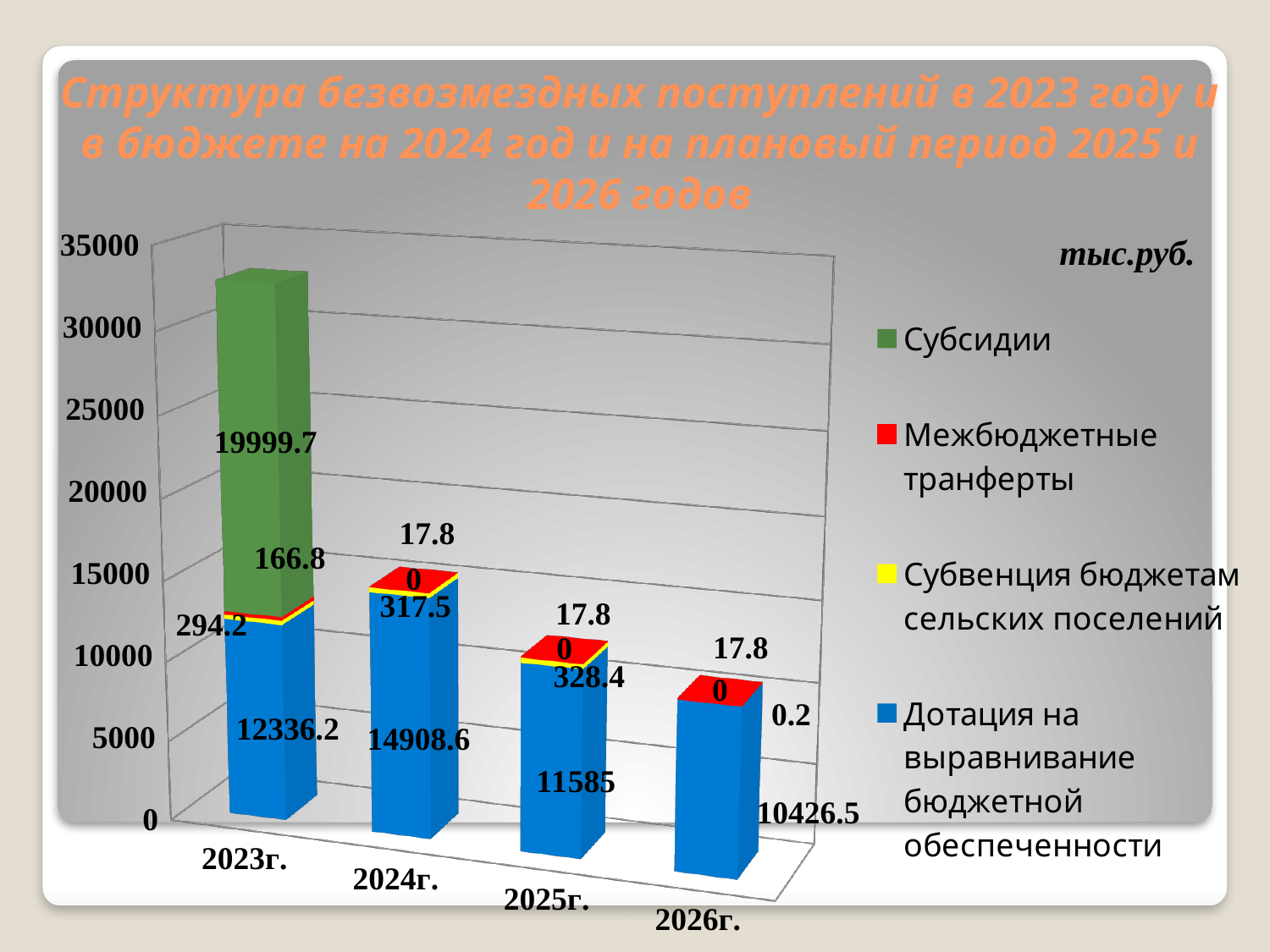
What is the value of Дотация на выравнивание бюджетной обеспеченности for 2023г.? 12336.2 In which year is Дотация на выравнивание бюджетной обеспеченности the highest? 2024г. How many years (categories) are shown on the x axis? 4 What is the total of the stacked bar for 2023г.? 32796.9 What kind of chart is shown on the slide? Stacked bar chart What is the value of Дотация на выравнивание бюджетной обеспеченности for 2024г.? 14908.6 In which year is Дотация на выравнивание бюджетной обеспеченности the lowest? 2026г. What is the value of Дотация на выравнивание бюджетной обеспеченности for 2026г.? 10426.5 What unit of measurement is indicated on the chart? тыс.руб. How many series does the legend list? 4 What is the value of Субсидии for 2023г.? 19999.7 By how much does Дотация на выравнивание бюджетной обеспеченности in 2024г. exceed that in 2023г.? 2572.4